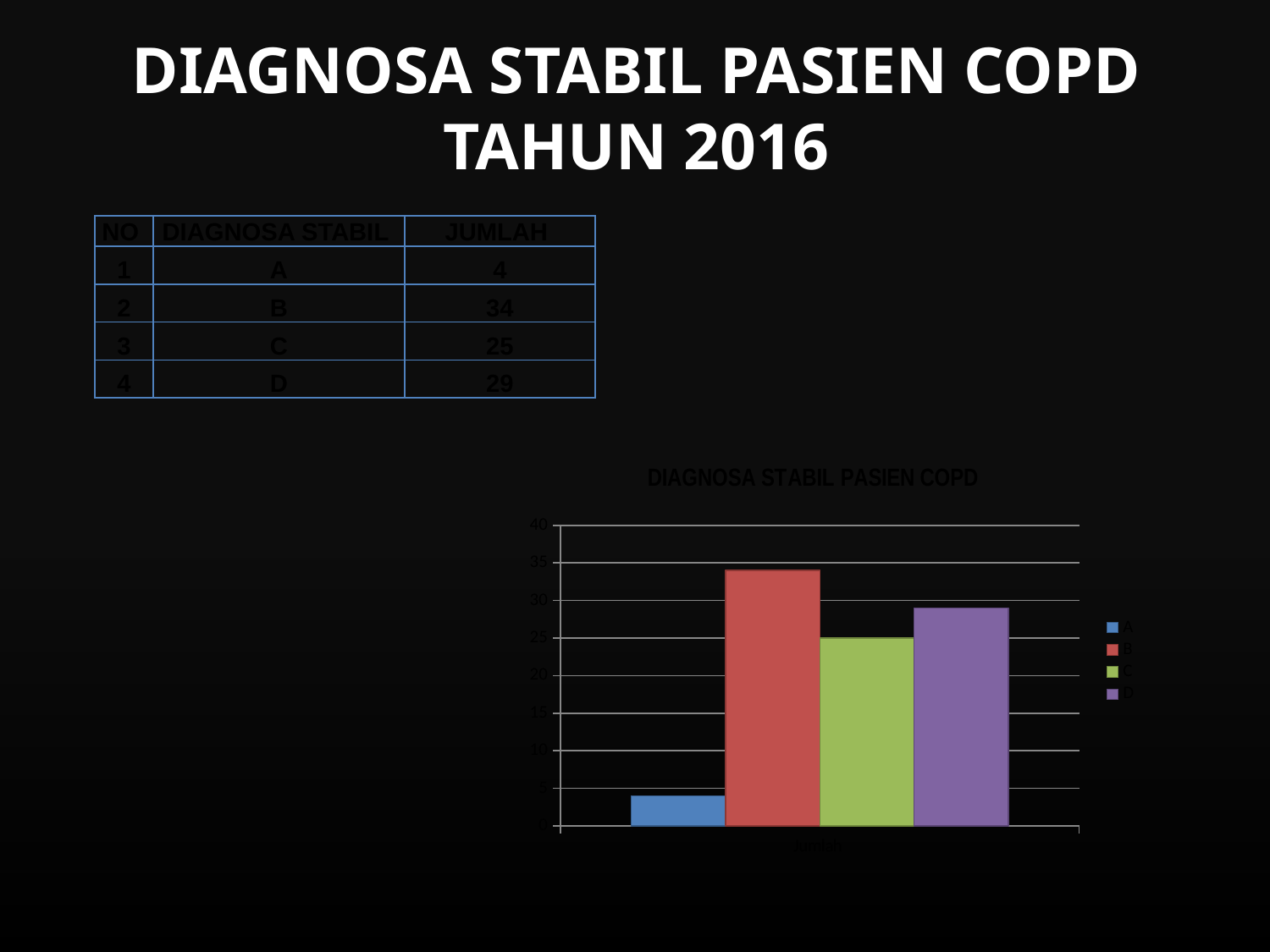
Is the bar for series A greater or less than 5? less Is the bar for series C greater or less than 20? greater Which series has the shortest bar in the chart? A Which is larger, the bar for C or the bar for D? D What is the value for series B? 34 What is the difference between the values for B and A? 30 What kind of chart is shown on the slide? bar chart How many series does the chart legend list? 4 What is the title of the chart? DIAGNOSA STABIL PASIEN COPD Which series has the tallest bar in the chart? B What is the value for series D? 29 What colour is the bar for series B? red